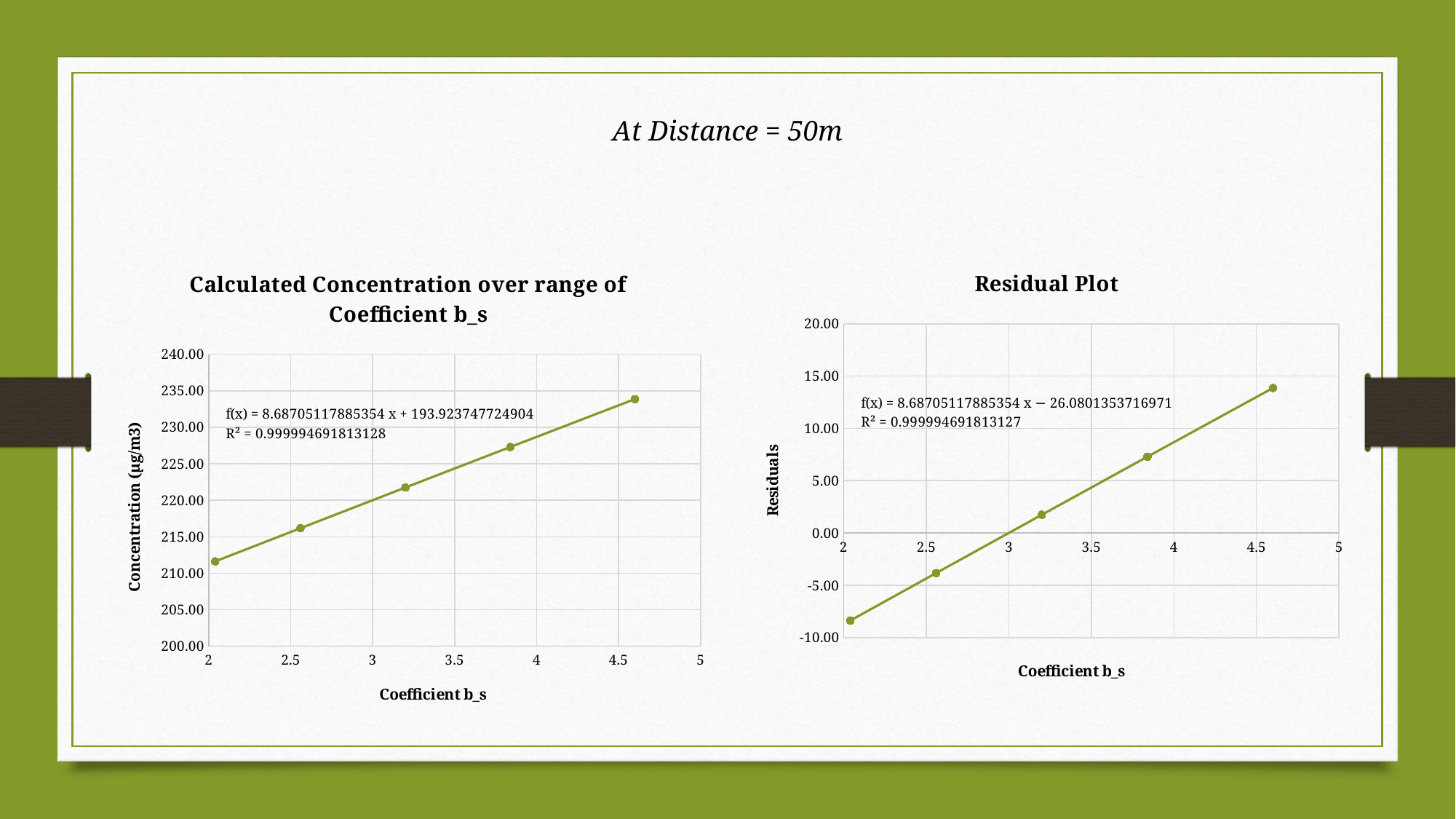
On the 'Calculated Concentration over range of Coefficient b_s' chart, is the concentration at the leftmost point greater or less than 215.00? less What R² value is printed on the 'Calculated Concentration over range of Coefficient b_s' chart? 0.999994691813128 On the 'Calculated Concentration over range of Coefficient b_s' chart, is the concentration at the rightmost point greater or less than 230.00? greater On the 'Calculated Concentration over range of Coefficient b_s' chart, do the values rise or fall as Coefficient b_s increases? rise On the 'Residual Plot' chart, is the residual at the leftmost point larger or smaller than the residual at the rightmost point? smaller What kind of chart is the 'Calculated Concentration over range of Coefficient b_s' chart? line chart How many data points are plotted on the 'Residual Plot' chart? 5 On the 'Calculated Concentration over range of Coefficient b_s' chart, does the highest concentration occur at the smallest or the largest Coefficient b_s value? largest On the 'Residual Plot' chart, is the residual at the leftmost point greater or less than -5.00? less How many data points are plotted on the 'Calculated Concentration over range of Coefficient b_s' chart? 5 On the 'Residual Plot' chart, do the residuals rise or fall as Coefficient b_s increases? rise